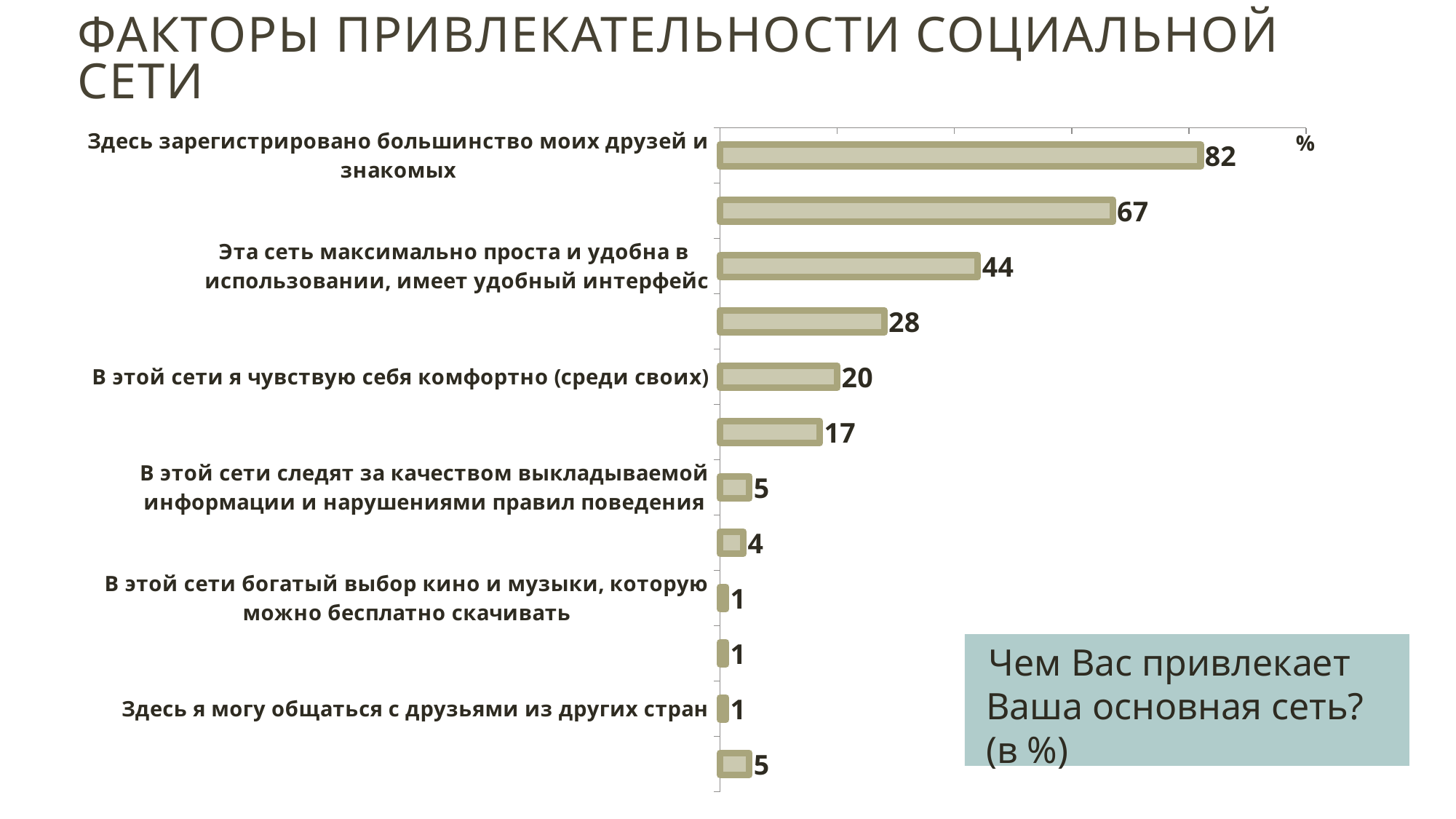
What is the value for "Здесь зарегистрировано большинство моих друзей и знакомых"? 82 What is the value for "В этой сети я чувствую себя комфортно (среди своих)"? 20 Which category has the highest value? Здесь зарегистрировано большинство моих друзей и знакомых How many bars are plotted on the chart? 12 What is the value for "Эта сеть максимально проста и удобна в использовании, имеет удобный интерфейс"? 44 What is the difference between the values for "Здесь зарегистрировано большинство моих друзей и знакомых" and "Эта сеть максимально проста и удобна в использовании, имеет удобный интерфейс"? 38 What type of chart is shown on the slide? bar chart What is the value for "В этой сети следят за качеством выкладываемой информации и нарушениями правил поведения"? 5 What is the lowest value shown on the chart? 1 Which is larger: the value for "В этой сети я чувствую себя комфортно (среди своих)" or for "В этой сети следят за качеством выкладываемой информации и нарушениями правил поведения"? В этой сети я чувствую себя комфортно (среди своих) What is the value for "Здесь я могу общаться с друзьями из других стран"? 1 What question is shown in the text box on the chart? Чем Вас привлекает Ваша основная сеть? (в %)